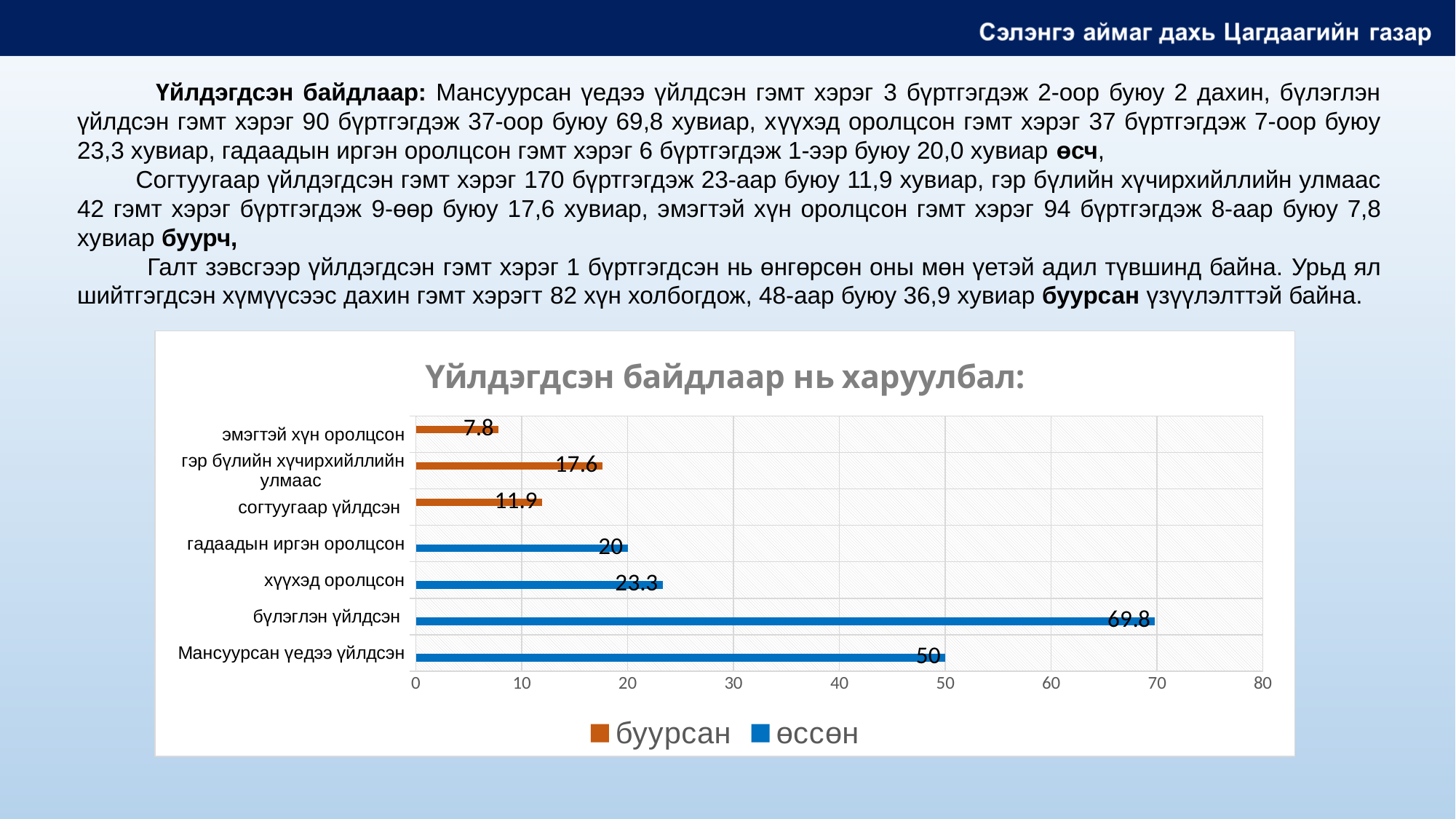
How many series does the legend list? 2 Which category has the lowest value? эмэгтэй хүн оролцсон How many categories are shown in the chart? 7 Is the value for согтуугаар үйлдсэн greater or less than 20? less What is the value for Мансуурсан үедээ үйлдсэн? 50 What is the value for гэр бүлийн хүчирхийллийн улмаас? 17.6 Which is larger, the value for хүүхэд оролцсон or the value for гадаадын иргэн оролцсон? хүүхэд оролцсон What type of chart is shown on the slide? bar chart Which category has the highest value? бүлэглэн үйлдсэн What is the value for эмэгтэй хүн оролцсон? 7.8 What is the difference between the values for бүлэглэн үйлдсэн and Мансуурсан үедээ үйлдсэн? 19.8 What is the value for бүлэглэн үйлдсэн? 69.8